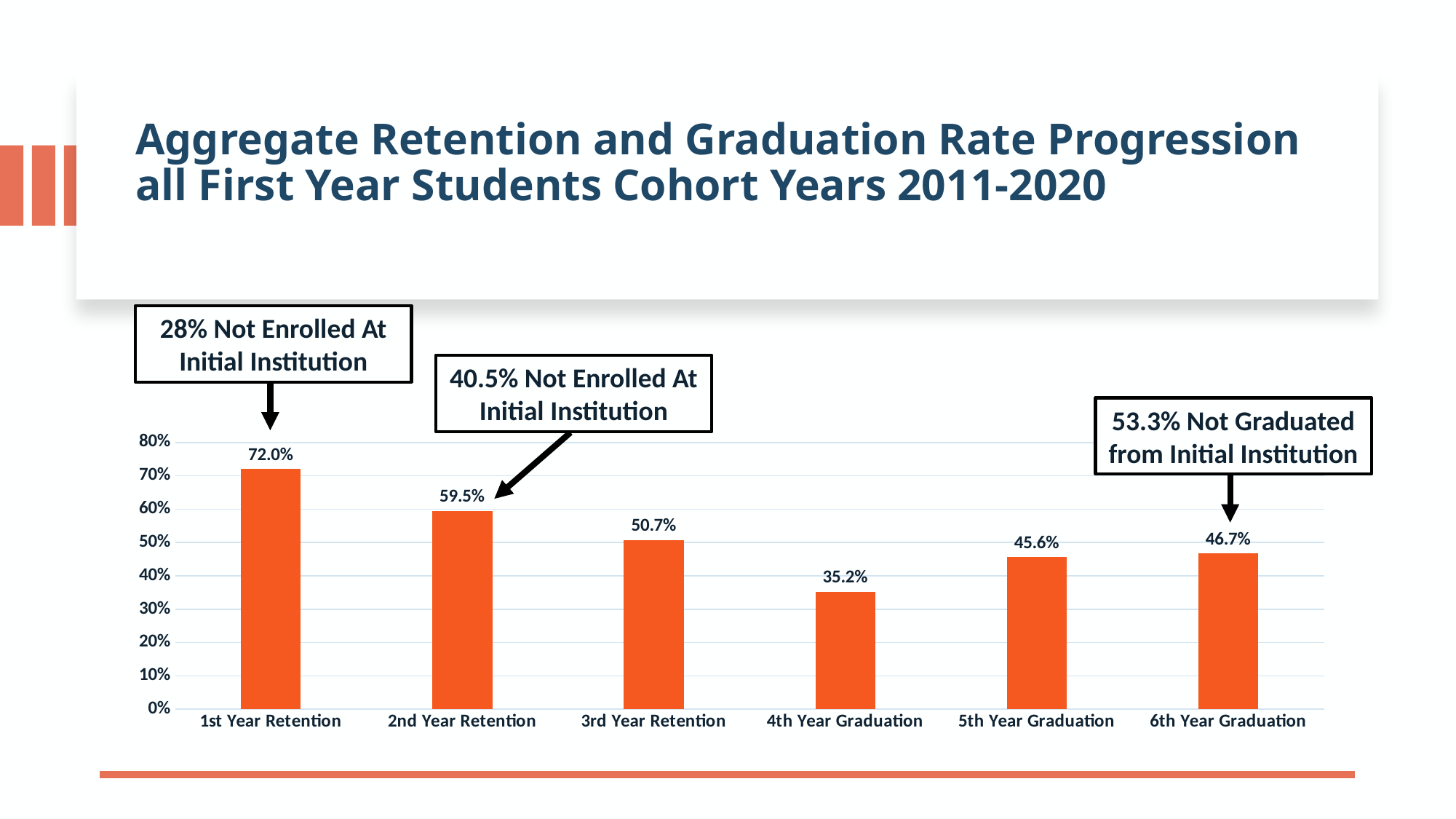
What is the value for 4th Year Graduation? 35.2% What is the difference between 6th Year Graduation and 5th Year Graduation? 1.1% What is the value for 6th Year Graduation? 46.7% What kind of chart is shown on the slide? Bar chart Which category has the lowest value? 4th Year Graduation What is the value for 1st Year Retention? 72.0% How many categories are shown on the x axis? 6 According to the callout box, what percentage were not graduated from the initial institution by the 6th year? 53.3% What is the difference between 1st Year Retention and 2nd Year Retention? 12.5% Which is larger, 3rd Year Retention or 5th Year Graduation? 3rd Year Retention Is the value for 2nd Year Retention greater or less than 50%? greater Which category has the highest value? 1st Year Retention